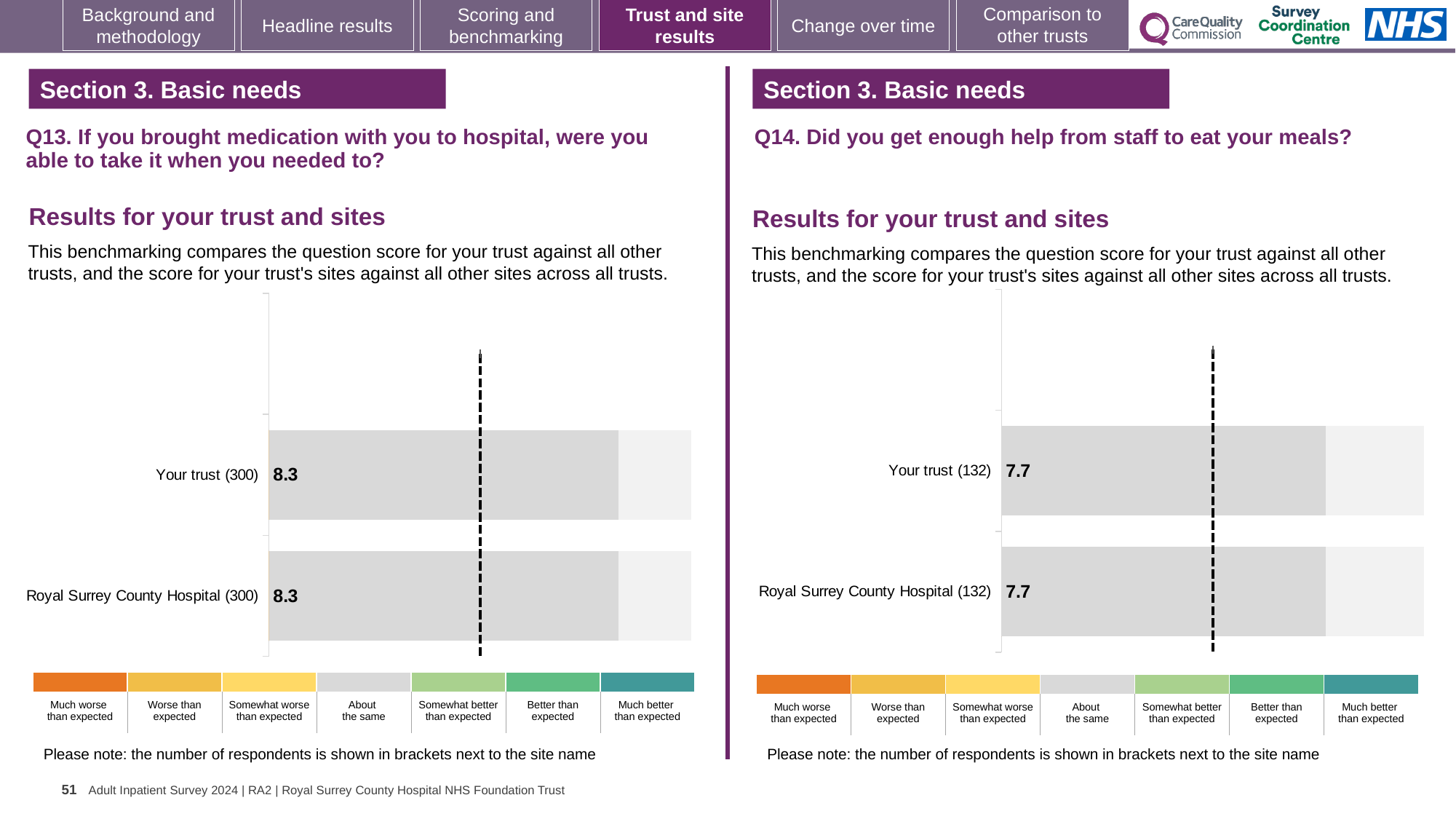
On the Q13 chart (left), what is the score for Your trust (300)? 8.3 How many bars are plotted on the Q13 chart (left)? 2 What is the label of the middle category in the colour key below the Q14 chart (right)? About the same What kind of chart is used on the Q13 chart (left)? Bar chart How many bars are plotted on the Q14 chart (right)? 2 On the Q14 chart (right), what is the score for Your trust (132)? 7.7 How many categories does the colour key below the Q13 chart (left) list? 7 On the Q13 chart (left), what is the score for Royal Surrey County Hospital (300)? 8.3 On the Q14 chart (right), what is the score for Royal Surrey County Hospital (132)? 7.7 On the Q13 chart (left), what is the difference between the score for Your trust and the score for Royal Surrey County Hospital? 0 How many respondents are shown in brackets for Your trust on the Q14 chart (right)? 132 On the Q14 chart (right), what is the difference between the score for Your trust and the score for Royal Surrey County Hospital? 0